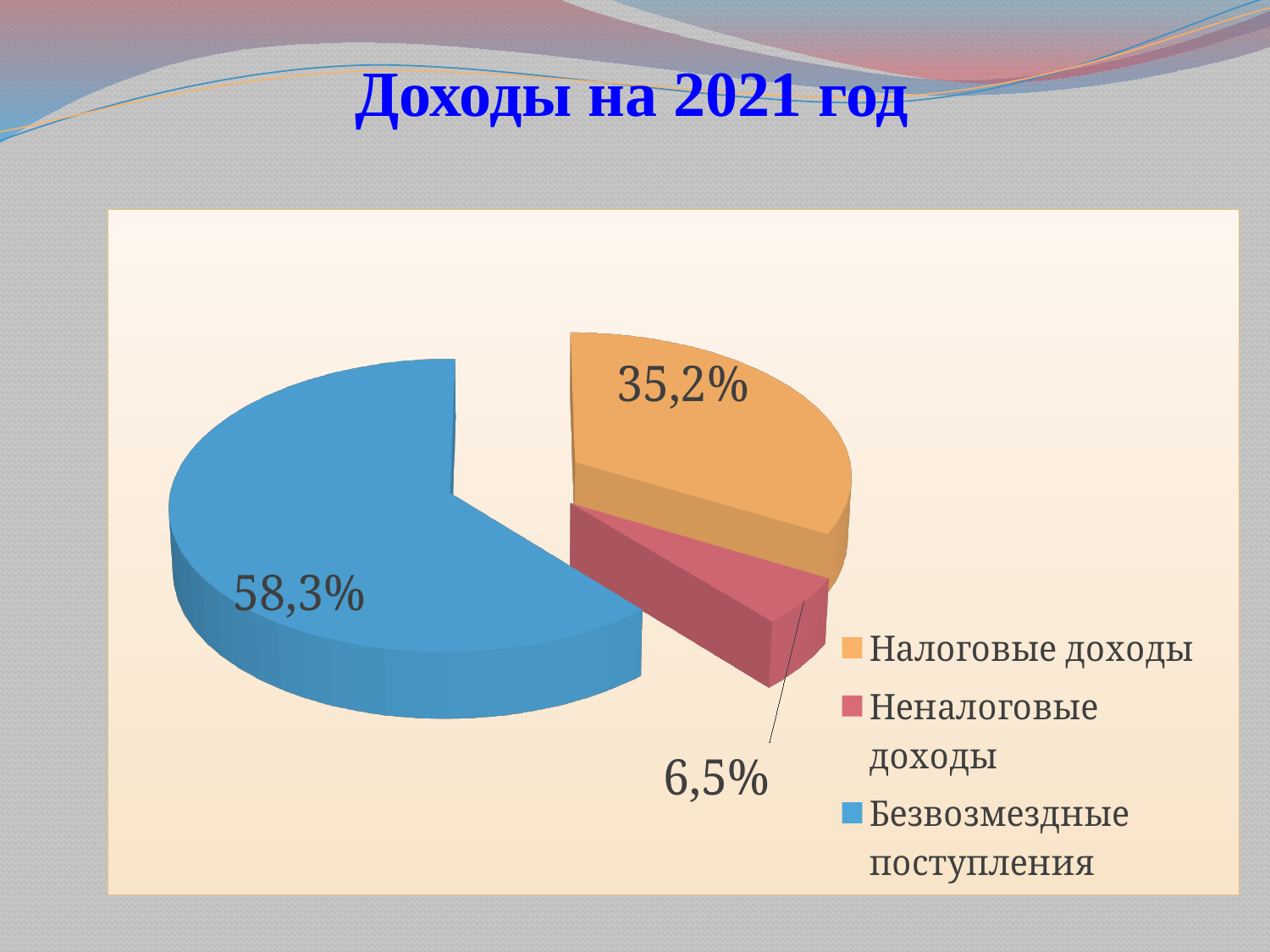
What colour is the slice for Безвозмездные поступления? blue What share of the pie does Неналоговые доходы have? 6,5% What share of the pie does Безвозмездные поступления have? 58,3% Which category has the smallest slice of the pie? Неналоговые доходы Which is larger, Налоговые доходы or Неналоговые доходы? Налоговые доходы What is the title of the slide? Доходы на 2021 год How many categories does the pie chart show? 3 What share of the pie does Налоговые доходы have? 35,2% What is the difference in percentage points between Безвозмездные поступления and Налоговые доходы? 23,1 What kind of chart is shown on the slide? pie chart What is the difference in percentage points between Налоговые доходы and Неналоговые доходы? 28,7 Which category has the largest slice of the pie? Безвозмездные поступления